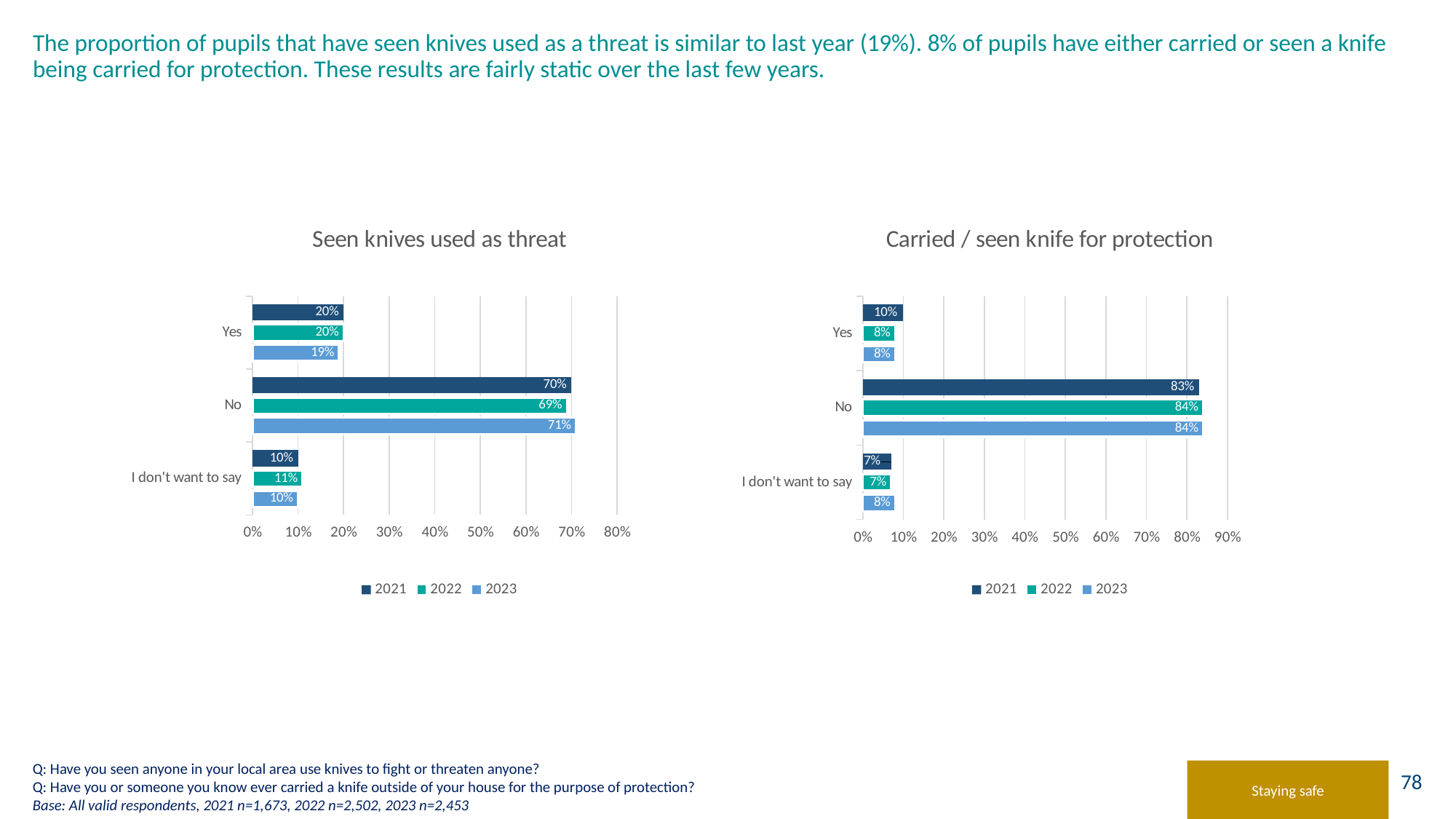
In the 'Carried / seen knife for protection' chart, what is the difference between the 'Yes' values for 2021 and 2023? 2% In the 'Carried / seen knife for protection' chart, which category has the lowest value for 2021? I don't want to say In the 'Seen knives used as threat' chart, what is the value for 'Yes' in 2023? 19% In the 'Carried / seen knife for protection' chart, what is the value for 'Yes' in 2021? 10% In the 'Seen knives used as threat' chart, what is the difference between the 'No' values for 2023 and 2022? 2% How many series does the legend list in the 'Carried / seen knife for protection' chart? 3 In the 'Seen knives used as threat' chart, which category has the highest value for 2023? No In the 'Seen knives used as threat' chart, what is the value for 'No' in 2022? 69% In the 'Seen knives used as threat' chart, is the 2021 value for 'I don't want to say' larger or smaller than the 2022 value? smaller In the 'Carried / seen knife for protection' chart, what is the value for 'I don't want to say' in 2023? 8% How many categories are shown in the 'Seen knives used as threat' chart? 3 What kind of chart is the 'Carried / seen knife for protection' chart? Bar chart